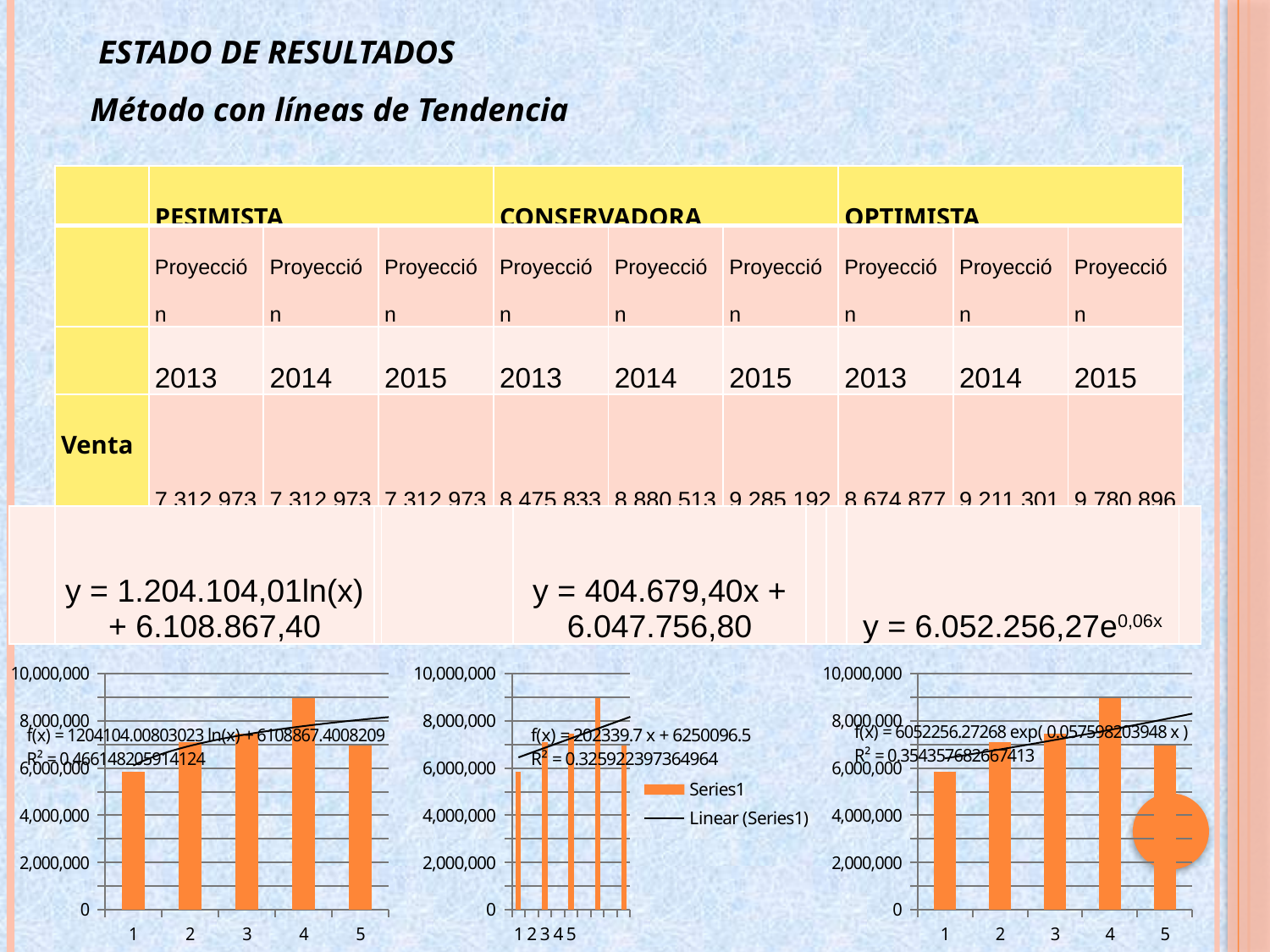
In the left chart, which category has the lowest bar? 1 In the right chart, is the value for category 4 greater or less than 8,000,000? greater In the left chart, is the value for category 4 greater or less than 8,000,000? greater In the left chart, is the value for category 1 greater or less than 4,000,000? greater In the left chart, how many bars are plotted? 5 In the right chart, which is larger, the value for category 4 or the value for category 5? 4 In the left chart, which category has the highest bar? 4 In the middle chart, how many series does the legend list? 2 What kind of chart is the left chart on the slide? bar chart In the middle chart, what are the two entries shown in the legend? Series1 and Linear (Series1) In the right chart, which category has the lowest bar? 1